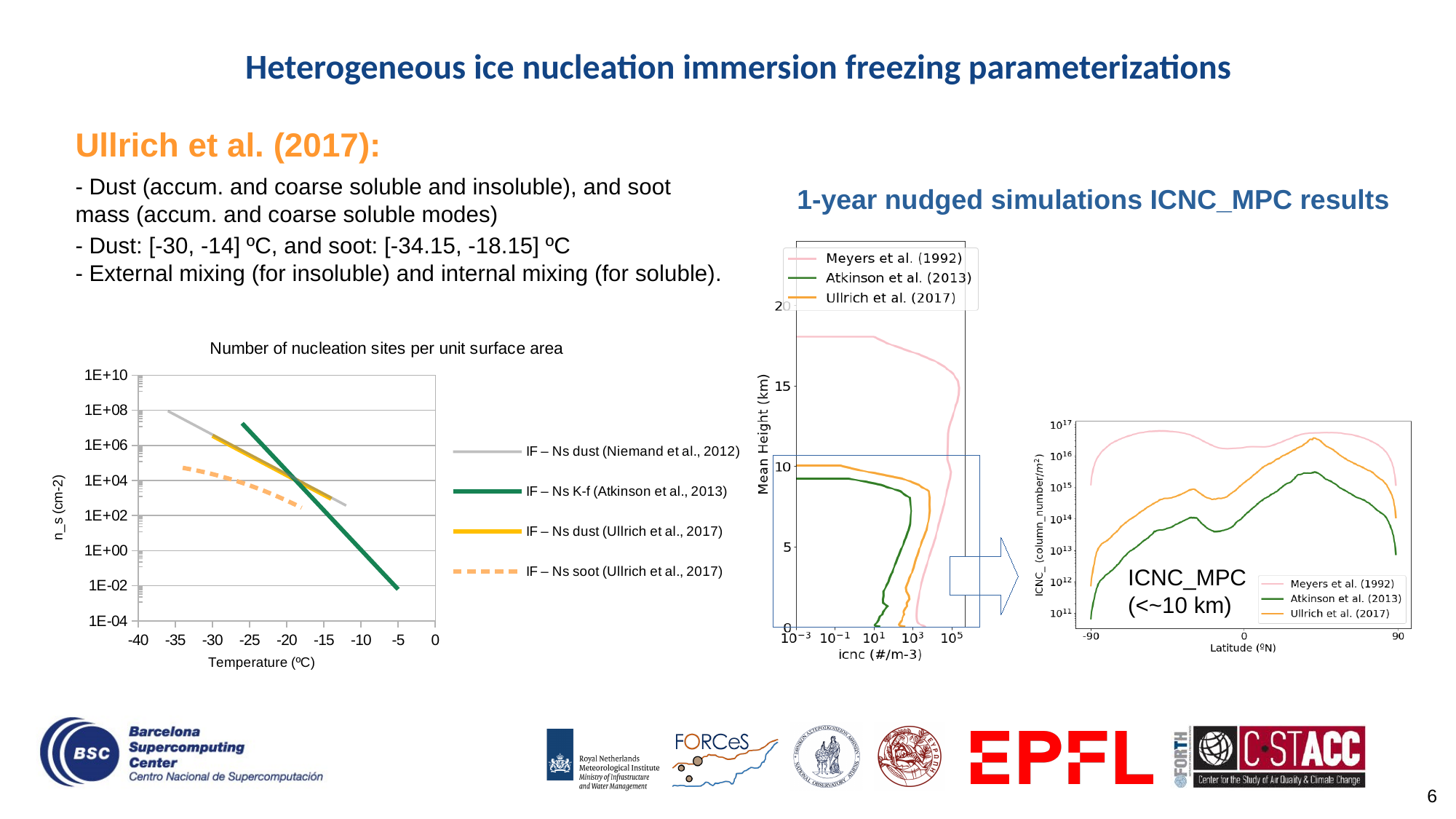
In the right chart (ICNC column number vs Latitude), which series has the lowest values across latitudes? Atkinson et al. (2013) In the middle chart (icnc vs Mean Height), which series extends to the greatest mean height? Meyers et al. (1992) What kind of chart is the 'Number of nucleation sites per unit surface area' chart on the left? line chart In the 'Number of nucleation sites per unit surface area' chart, do the values rise or fall as temperature increases from -40 to 0 ºC? fall In the right chart (ICNC column number vs Latitude), which is larger at 0 ºN latitude: the Ullrich et al. (2017) value or the Atkinson et al. (2013) value? Ullrich et al. (2017) In the 'Number of nucleation sites per unit surface area' chart, which series is drawn with a dashed line? IF – Ns soot (Ullrich et al., 2017) How many series does the legend of the 'Number of nucleation sites per unit surface area' chart list? 4 What is the x-axis label of the 'Number of nucleation sites per unit surface area' chart? Temperature (ºC) How many series does the legend of the middle chart (icnc vs Mean Height) list? 3 In the right chart (ICNC column number vs Latitude), which series has the highest values across latitudes? Meyers et al. (1992) In the middle chart (icnc vs Mean Height), is the maximum height reached by the Atkinson et al. (2013) line greater or less than 15 km? less In the middle chart (icnc vs Mean Height), is the maximum height reached by the Meyers et al. (1992) line greater or less than 15 km? greater